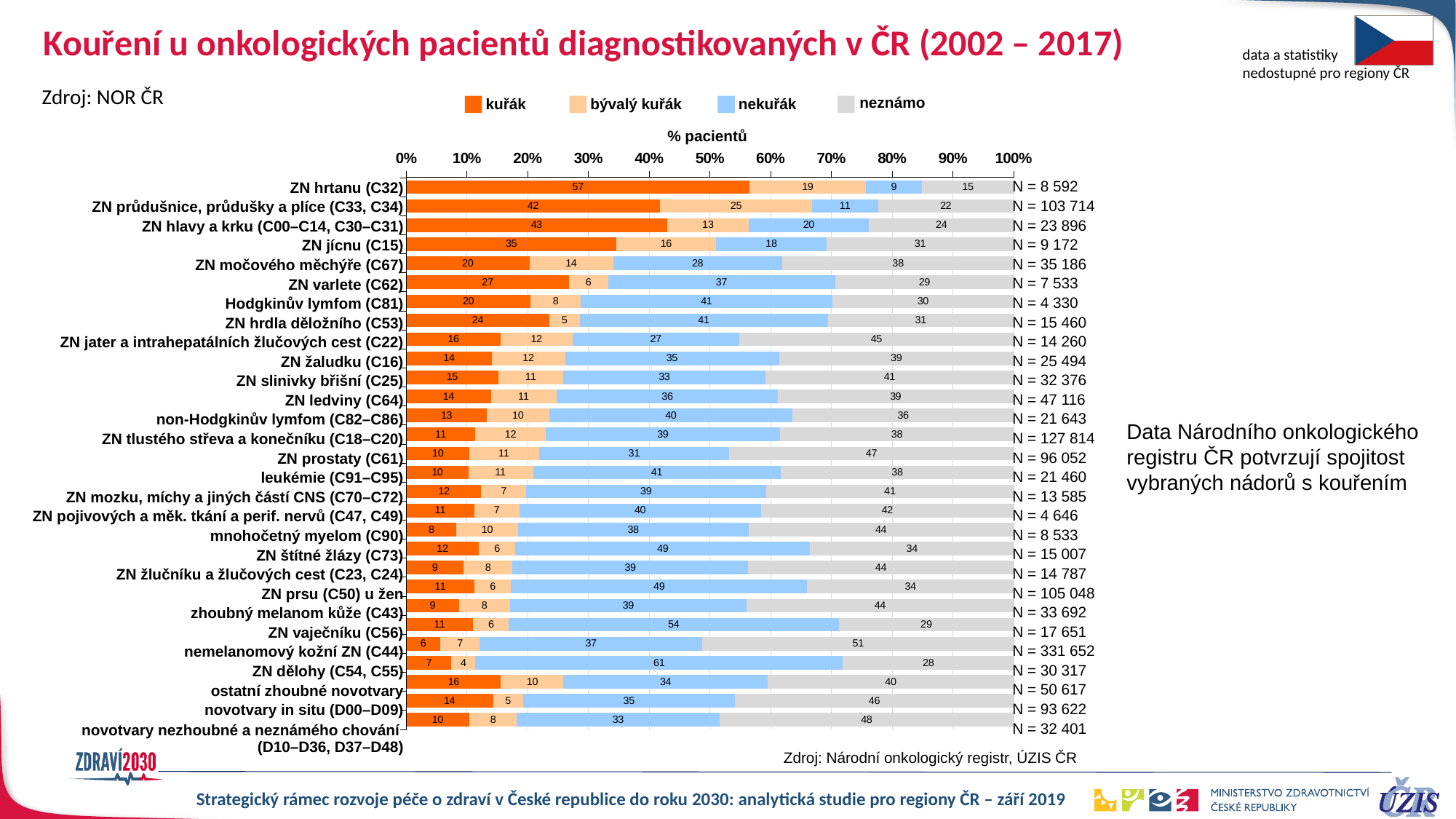
Which diagnosis has the lowest kuřák percentage? nemelanomový kožní ZN (C44) Which has a larger nekuřák value: ZN vaječníku (C56) or ZN prsu (C50) u žen? ZN vaječníku (C56) What is the total of the four segments for ZN hrtanu (C32)? 100 What is the difference between the kuřák values for ZN hrtanu (C32) and ZN průdušnice, průdušky a plíce (C33, C34)? 15 Which diagnosis has the highest kuřák percentage? ZN hrtanu (C32) How many series does the legend list? 4 What kind of chart is shown on the slide? Stacked bar chart What percentage of patients with ZN hrtanu (C32) are labelled kuřák? 57 What is the nekuřák value for ZN dělohy (C54, C55)? 61 What is the neznámo value for nemelanomový kožní ZN (C44)? 51 What is the N value shown for ZN průdušnice, průdušky a plíce (C33, C34)? N = 103 714 What are the four legend entries of the chart? kuřák, bývalý kuřák, nekuřák, neznámo